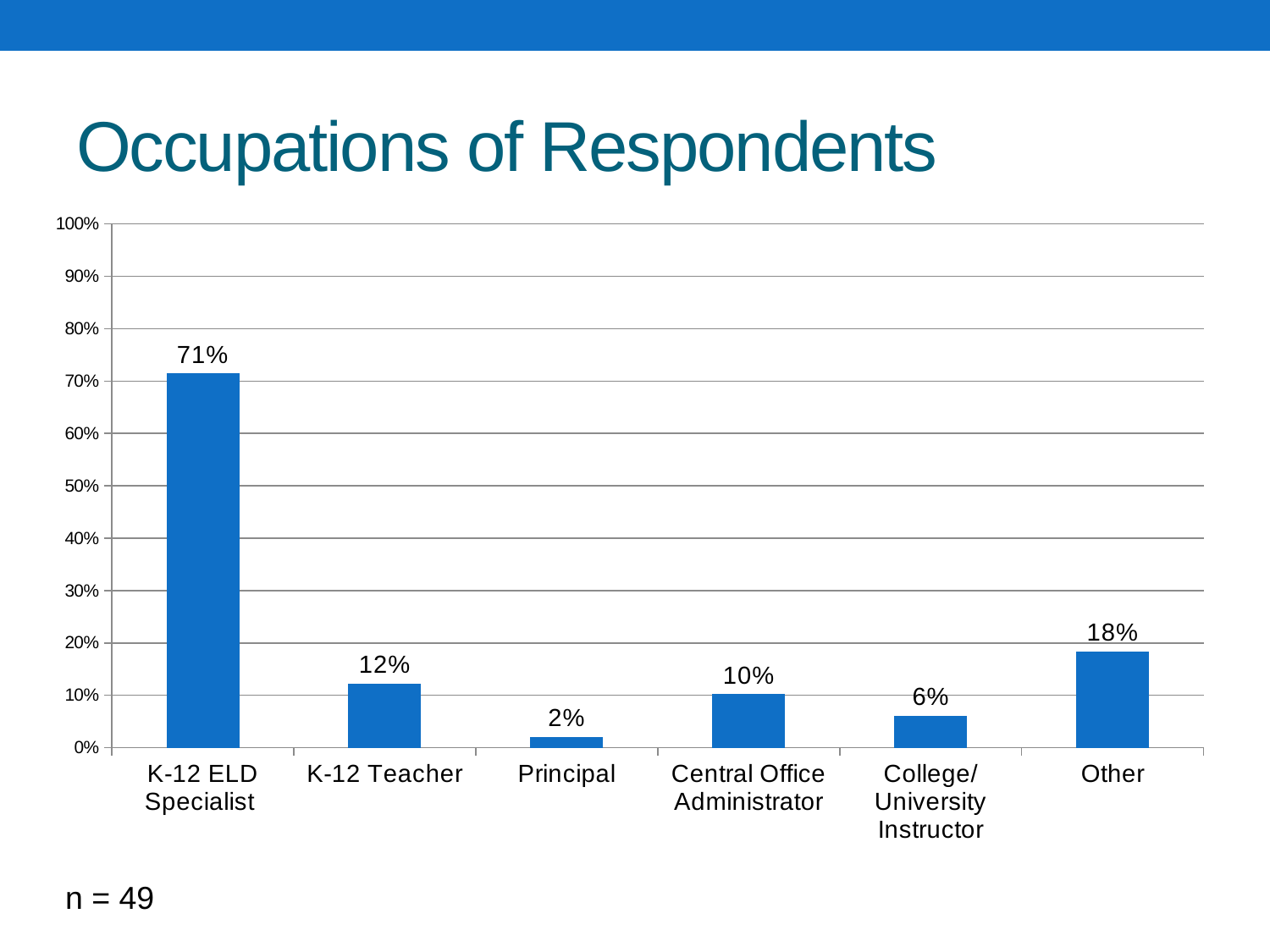
How many occupation categories are shown on the chart? 6 What is the value for College/University Instructor? 6% What is the title of the slide? Occupations of Respondents Which occupation has the lowest percentage of respondents? Principal Which occupation has the highest percentage of respondents? K-12 ELD Specialist What is the value for Central Office Administrator? 10% What percentage of respondents are Principals? 2% What percentage of respondents are K-12 ELD Specialists? 71% What is the difference between the K-12 ELD Specialist and Other percentages? 53% What is the difference between the K-12 Teacher and Central Office Administrator percentages? 2% What kind of chart is shown on the slide? Bar chart Which is larger, the value for Other or the value for K-12 Teacher? Other